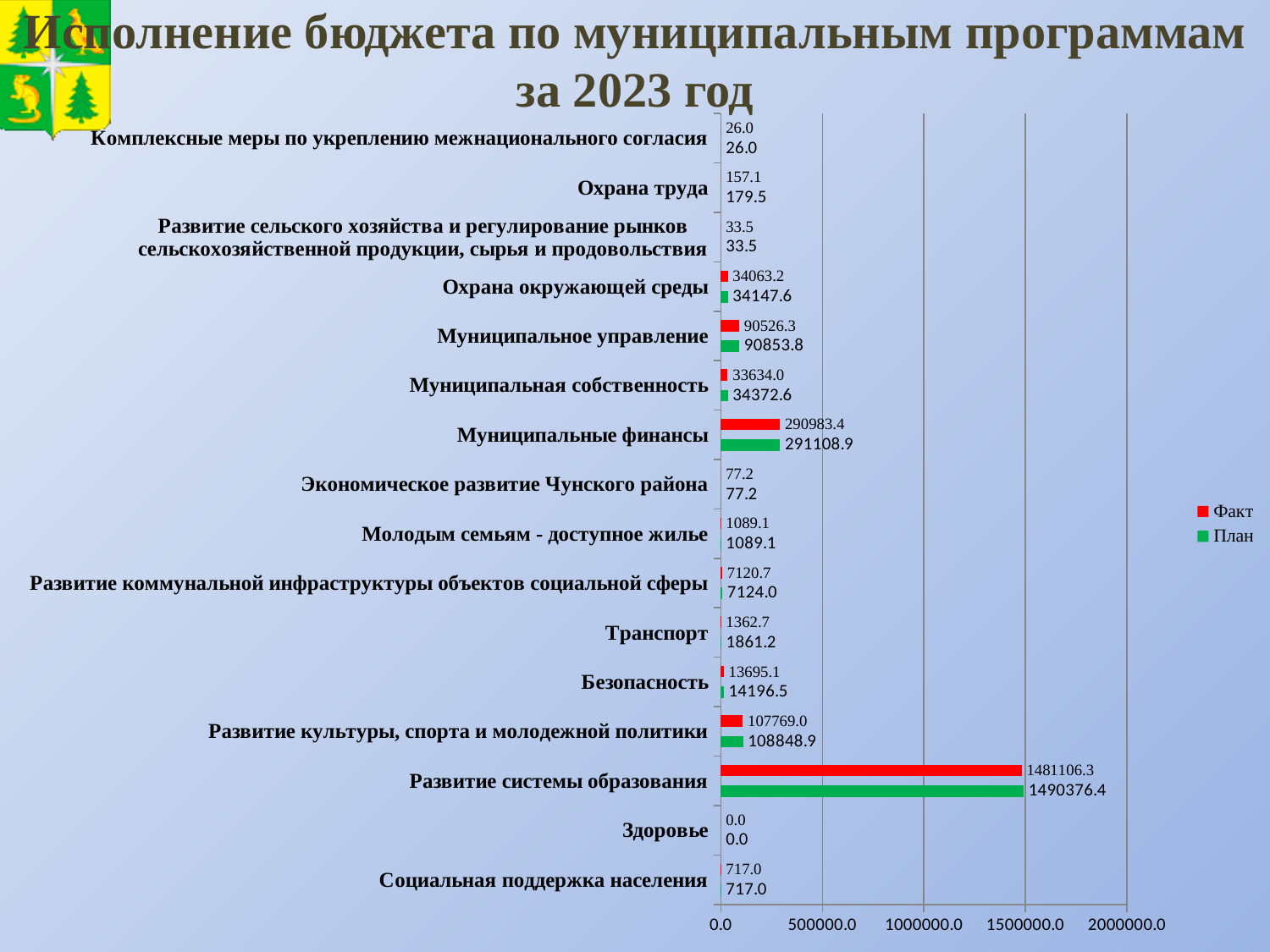
Which is larger for Транспорт: the Факт value or the План value? План What is the План value for Муниципальные финансы? 291108.9 How many categories (municipal programs) are shown on the chart? 16 What is the Факт value for Транспорт? 1362.7 What is the План value for Безопасность? 14196.5 Which category has the lowest Факт value? Здоровье What is the difference between the План and Факт values for Развитие системы образования? 9270.1 What is the Факт value for Развитие системы образования? 1481106.3 What type of chart is shown on the slide? bar chart Which category has the highest План value? Развитие системы образования Which series is shown in red in the legend? Факт How many series does the legend list? 2